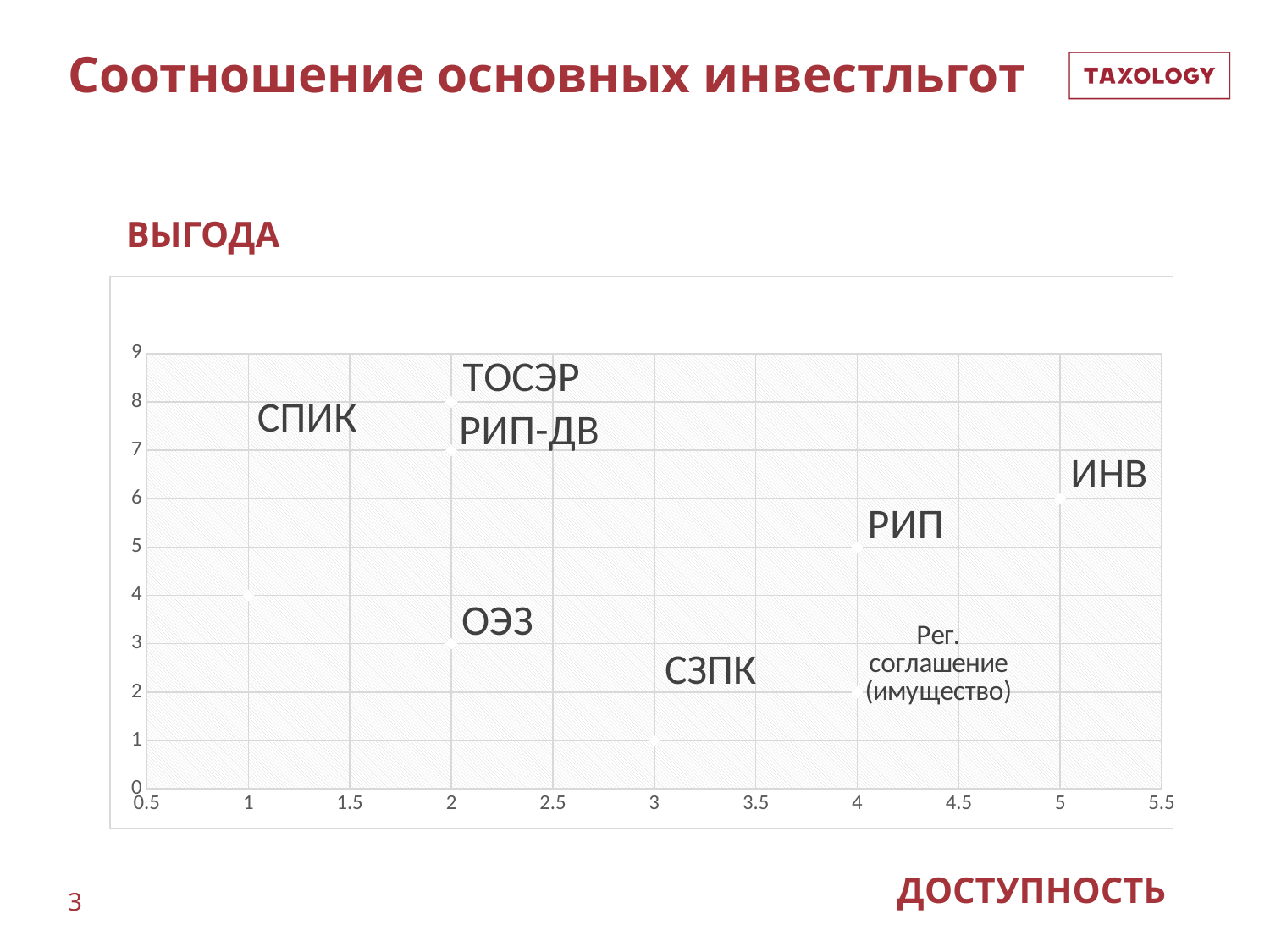
How many labelled points are plotted on the chart? 8 What is the ДОСТУПНОСТЬ (horizontal axis) value for ИНВ? 5 What is the ВЫГОДА value for СЗПК? 1 Which point has the highest ВЫГОДА value? ТОСЭР What kind of chart is shown on the slide? scatter chart Which point has the lowest ВЫГОДА value? СЗПК Which has a higher ВЫГОДА value, РИП or Рег. соглашение (имущество)? РИП What is the difference in ВЫГОДА between РИП-ДВ and ОЭЗ? 4 Which point has the highest ДОСТУПНОСТЬ value? ИНВ What is the ВЫГОДА (vertical axis) value for ТОСЭР? 8 What is the ДОСТУПНОСТЬ value for СПИК? 1 What is the title of the chart on the slide? Соотношение основных инвестльгот